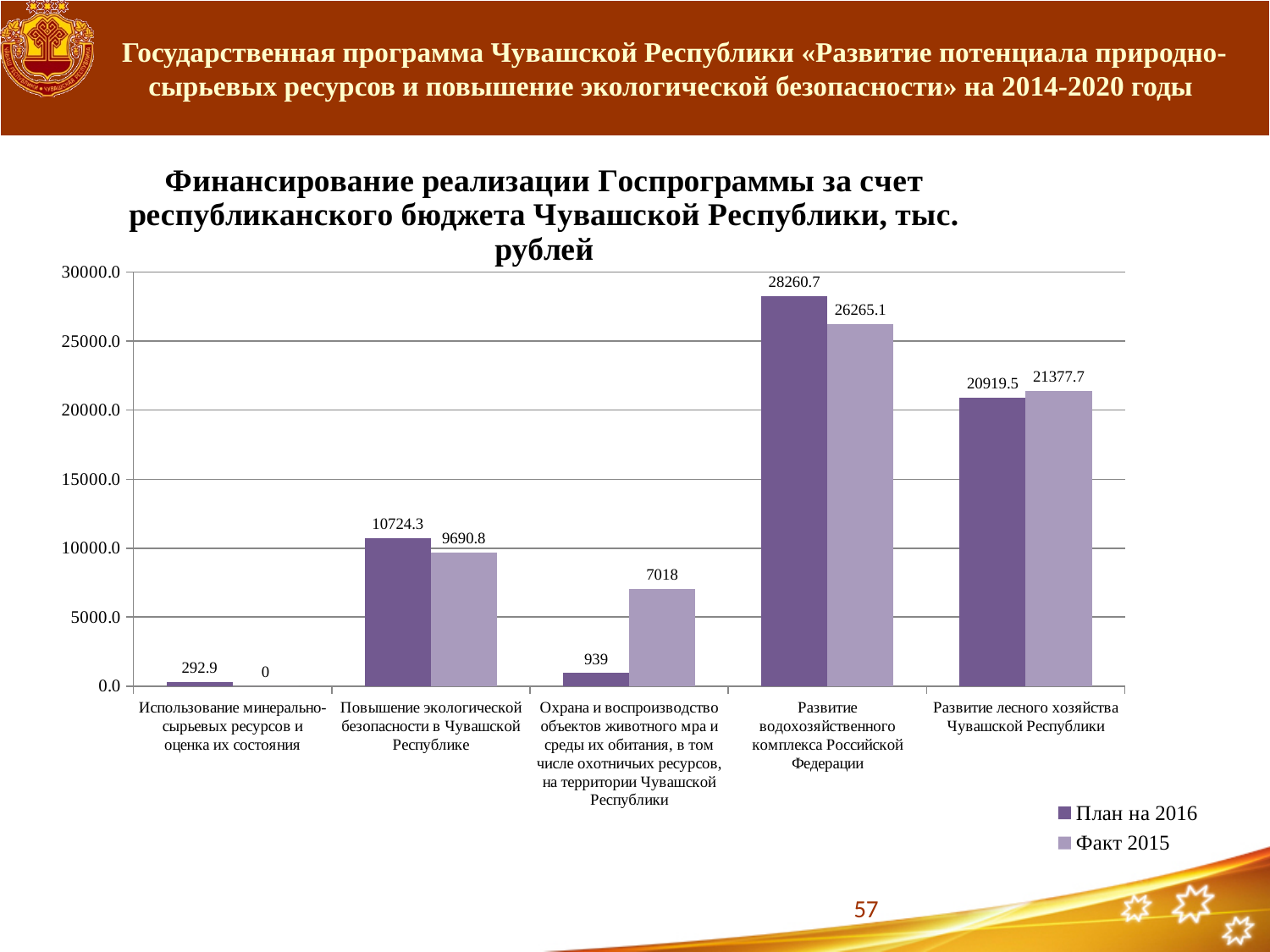
What is the value of "Факт 2015" for "Повышение экологической безопасности в Чувашской Республике"? 9690.8 What is the difference between "Факт 2015" and "План на 2016" for "Охрана и воспроизводство объектов животного мира и среды их обитания, в том числе охотничьих ресурсов, на территории Чувашской Республики"? 6079 How many categories are shown on the x axis of the chart? 5 Which category has the highest "План на 2016" value? Развитие водохозяйственного комплекса Российской Федерации What type of chart is shown on the slide? bar chart What is the difference between "План на 2016" and "Факт 2015" for "Развитие водохозяйственного комплекса Российской Федерации"? 1995.6 What is the value of "Факт 2015" for "Использование минерально-сырьевых ресурсов и оценка их состояния"? 0 For "Развитие лесного хозяйства Чувашской Республики", which is larger: "План на 2016" or "Факт 2015"? Факт 2015 How many series does the chart legend list? 2 Is the "Факт 2015" value for "Развитие водохозяйственного комплекса Российской Федерации" greater or less than 25000.0? greater Which category has the lowest "План на 2016" value? Использование минерально-сырьевых ресурсов и оценка их состояния What is the value of "План на 2016" for "Развитие водохозяйственного комплекса Российской Федерации"? 28260.7